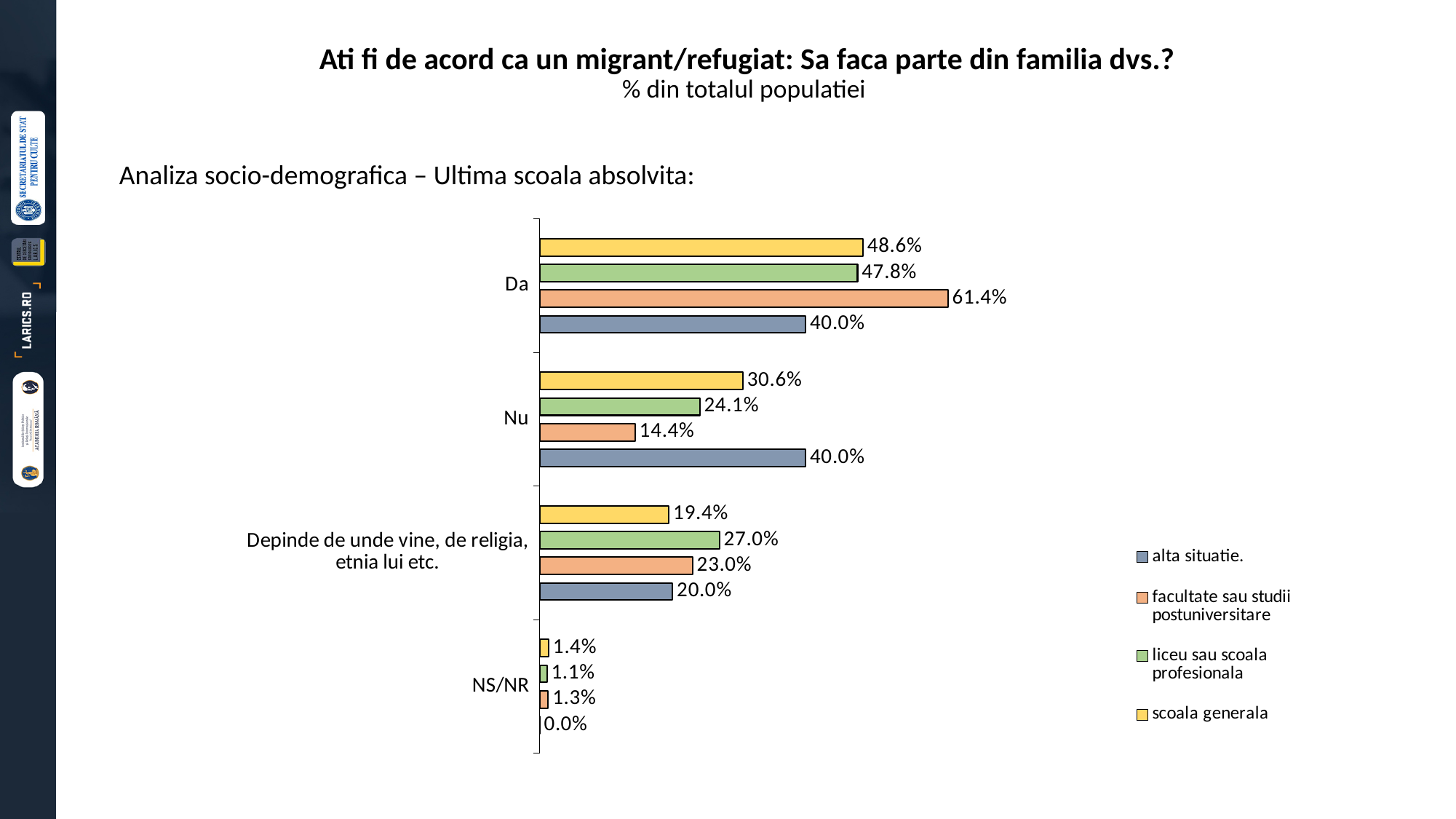
What is the value for 'scoala generala' in the 'Nu' category? 30.6% What is the value for 'facultate sau studii postuniversitare' in the 'Da' category? 61.4% What is the difference between the 'facultate sau studii postuniversitare' values for 'Da' and 'Nu'? 47.0% What is the value for 'liceu sau scoala profesionala' in the 'NS/NR' category? 1.1% What is the value for 'alta situatie.' in the 'Depinde de unde vine, de religia, etnia lui etc.' category? 20.0% Which series has the highest value in the 'Da' category? facultate sau studii postuniversitare How many series does the legend list? 4 What kind of chart is shown on the slide? bar chart Which series has the lowest value in the 'Nu' category? facultate sau studii postuniversitare How many response categories are shown on the chart? 4 Which is larger in the 'Depinde de unde vine, de religia, etnia lui etc.' category: 'liceu sau scoala profesionala' or 'scoala generala'? liceu sau scoala profesionala What colour represents 'scoala generala' in the legend? yellow